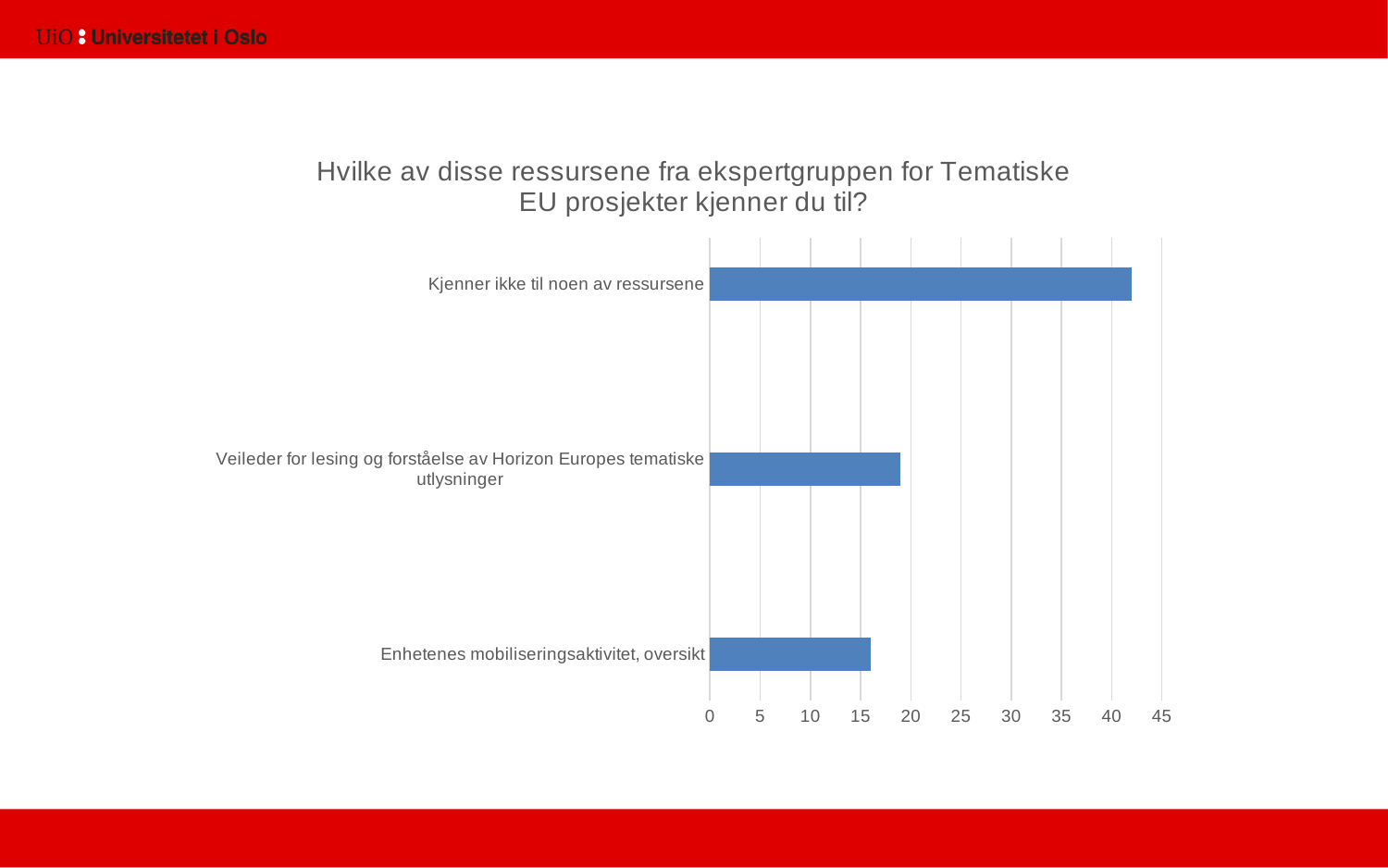
How many categories are shown in the chart? 3 Which is larger: the value for 'Veileder for lesing og forståelse av Horizon Europes tematiske utlysninger' or the value for 'Enhetenes mobiliseringsaktivitet, oversikt'? Veileder for lesing og forståelse av Horizon Europes tematiske utlysninger Is the value for 'Kjenner ikke til noen av ressursene' greater or less than 40? greater Which category has the lowest value? Enhetenes mobiliseringsaktivitet, oversikt Is the value for 'Enhetenes mobiliseringsaktivitet, oversikt' greater or less than 20? less Is the value for 'Veileder for lesing og forståelse av Horizon Europes tematiske utlysninger' greater or less than 15? greater What is the highest value shown on the horizontal axis of the chart? 45 What is the title of the chart? Hvilke av disse ressursene fra ekspertgruppen for Tematiske EU prosjekter kjenner du til? What kind of chart is shown on the slide? bar chart Which category has the highest value? Kjenner ikke til noen av ressursene